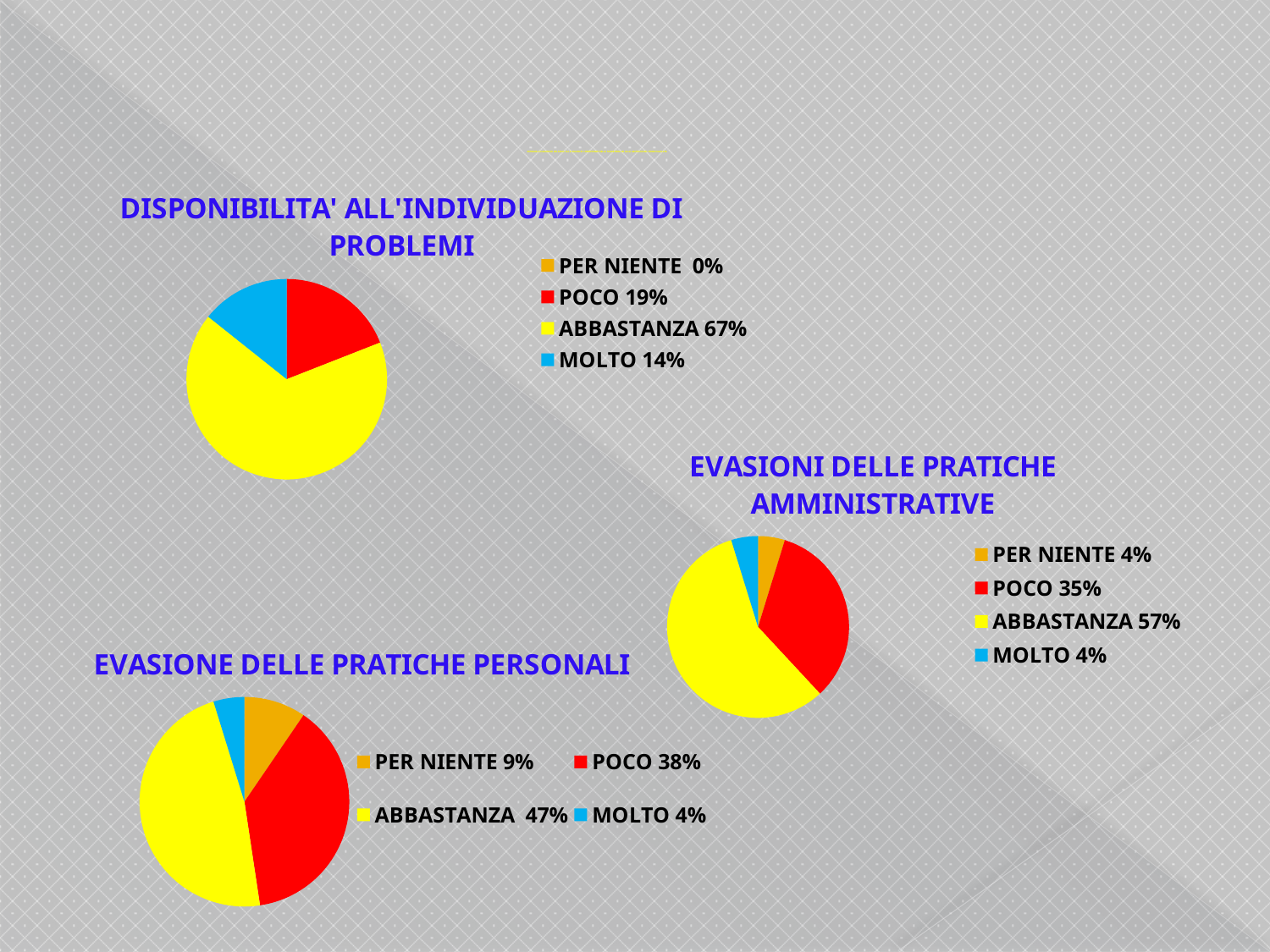
In the 'EVASIONI DELLE PRATICHE AMMINISTRATIVE' chart, what is the difference between ABBASTANZA and POCO? 22% In the 'DISPONIBILITA' ALL'INDIVIDUAZIONE DI PROBLEMI' chart, what share does ABBASTANZA have? 67% In the 'EVASIONI DELLE PRATICHE AMMINISTRATIVE' chart, which category has the highest value? ABBASTANZA In the 'DISPONIBILITA' ALL'INDIVIDUAZIONE DI PROBLEMI' chart, what is the difference between ABBASTANZA and POCO? 48% In the 'DISPONIBILITA' ALL'INDIVIDUAZIONE DI PROBLEMI' chart, what is the value for MOLTO? 14% How many categories does the legend of the 'EVASIONE DELLE PRATICHE PERSONALI' chart list? 4 In the 'DISPONIBILITA' ALL'INDIVIDUAZIONE DI PROBLEMI' chart, which category has the lowest value? PER NIENTE In the 'EVASIONE DELLE PRATICHE PERSONALI' chart, which is larger, POCO or ABBASTANZA? ABBASTANZA In the 'EVASIONE DELLE PRATICHE PERSONALI' chart, what is the value for PER NIENTE? 9% In the 'EVASIONE DELLE PRATICHE PERSONALI' chart, which category has the lowest value? MOLTO What kind of chart is used for 'EVASIONI DELLE PRATICHE AMMINISTRATIVE'? Pie chart In the 'EVASIONI DELLE PRATICHE AMMINISTRATIVE' chart, what is the value for POCO? 35%